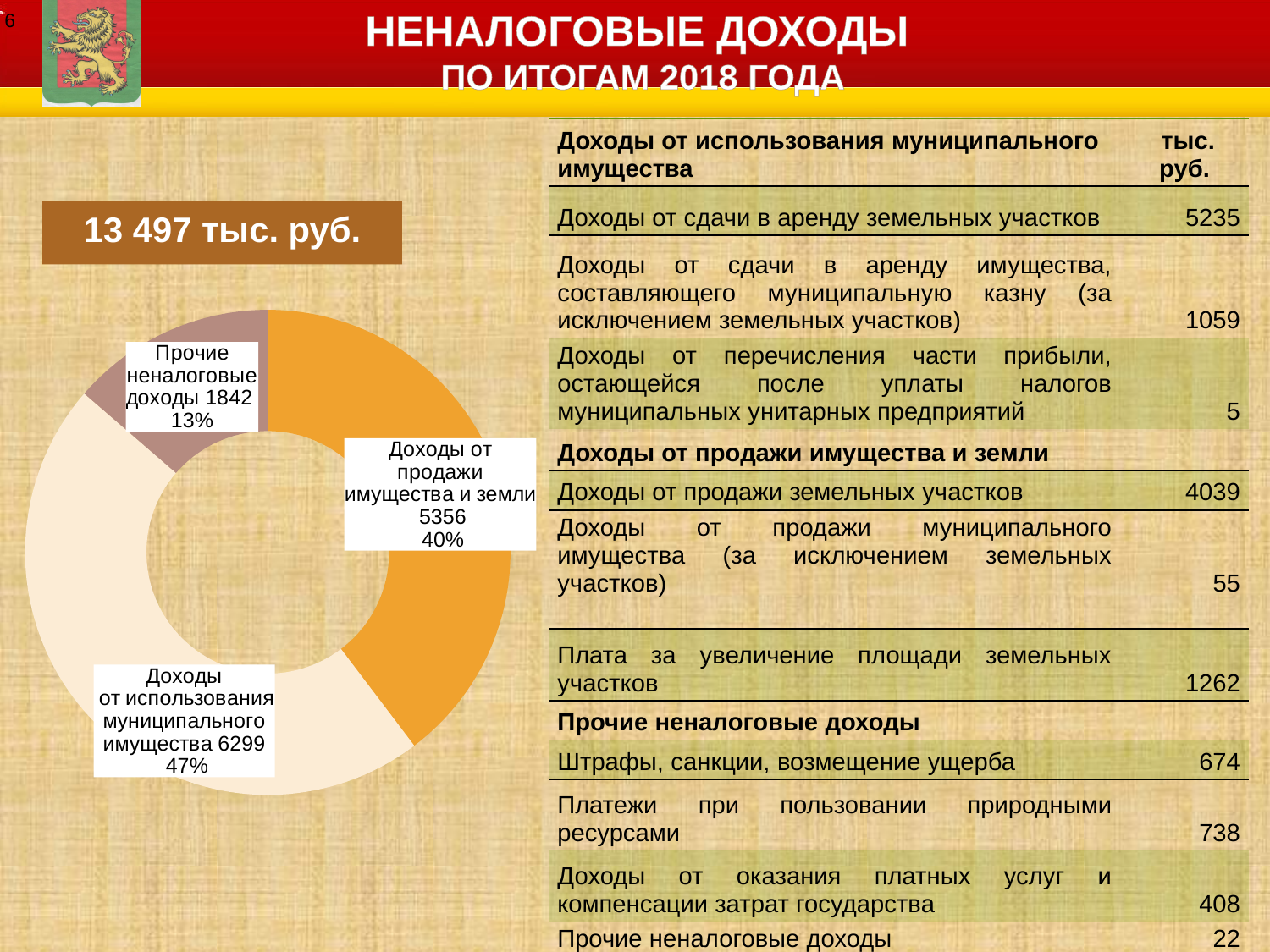
What share of the doughnut chart does "Прочие неналоговые доходы" represent? 13% What is the value for "Доходы от продажи имущества и земли" in the doughnut chart? 5356 What is the value for "Доходы от использования муниципального имущества" in the doughnut chart? 6299 What is the value for "Прочие неналоговые доходы" in the doughnut chart? 1842 Which is larger in the doughnut chart: "Доходы от продажи имущества и земли" or "Прочие неналоговые доходы"? Доходы от продажи имущества и земли Which category has the smallest slice in the doughnut chart? Прочие неналоговые доходы What share of the doughnut chart does "Доходы от продажи имущества и земли" represent? 40% How many slices does the doughnut chart have? 3 What kind of chart is shown on the left of the slide? doughnut (pie) chart What total amount is shown in the box above the doughnut chart? 13 497 тыс. руб. What is the difference between the values for "Доходы от использования муниципального имущества" and "Доходы от продажи имущества и земли" in the doughnut chart? 943 Which category has the largest slice in the doughnut chart? Доходы от использования муниципального имущества